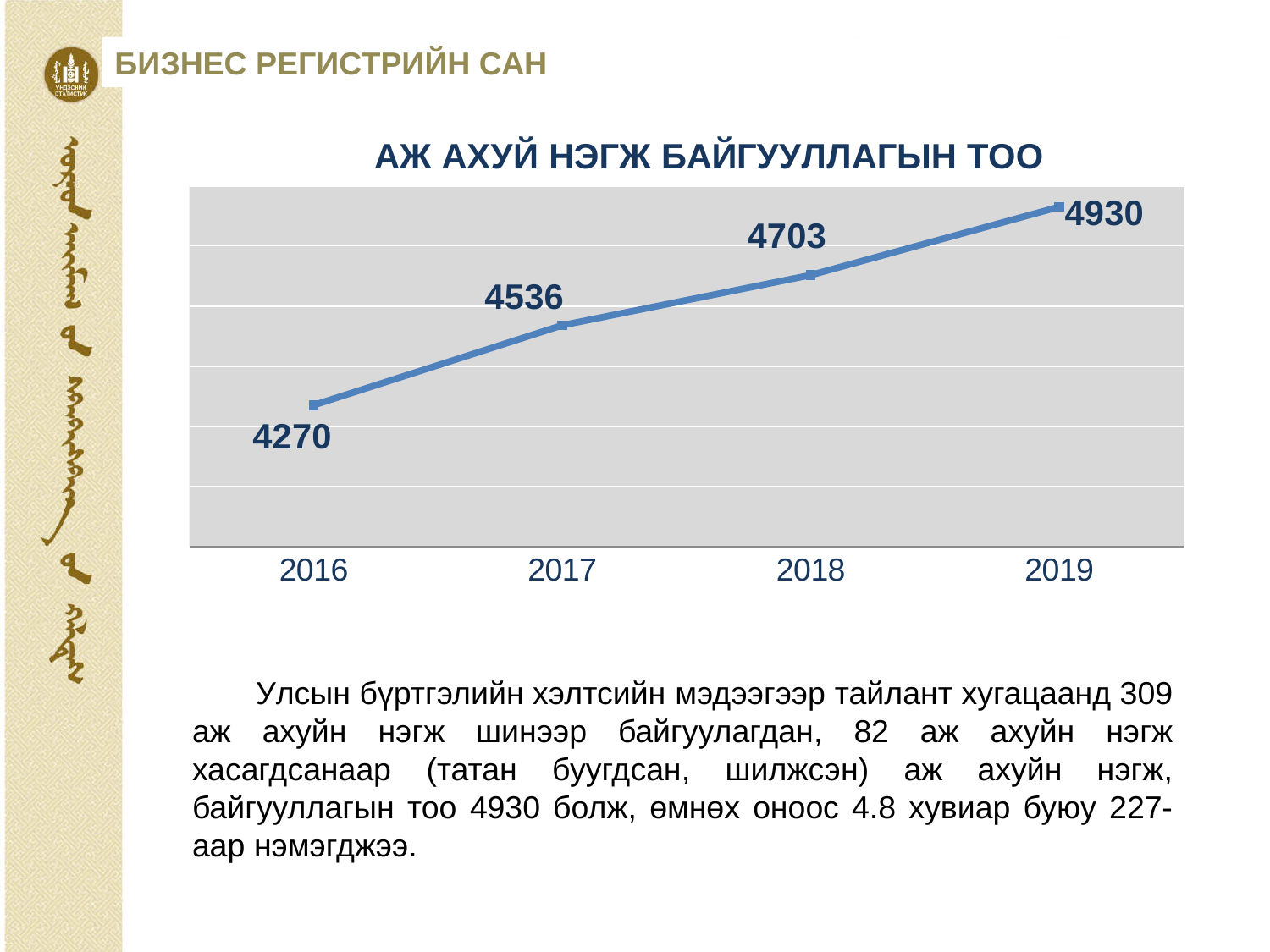
How many years are plotted on the chart? 4 Which year has the highest value? 2019 What kind of chart is shown? line chart What is the value for 2016? 4270 What is the value for 2017? 4536 What is the value for 2018? 4703 What is the difference between the values for 2017 and 2016? 266 Which year has the lowest value? 2016 Which is larger, the value for 2017 or the value for 2018? 2018 Do the values rise or fall from 2016 to 2019? rise What is the difference between the values for 2019 and 2018? 227 What is the value for 2019? 4930